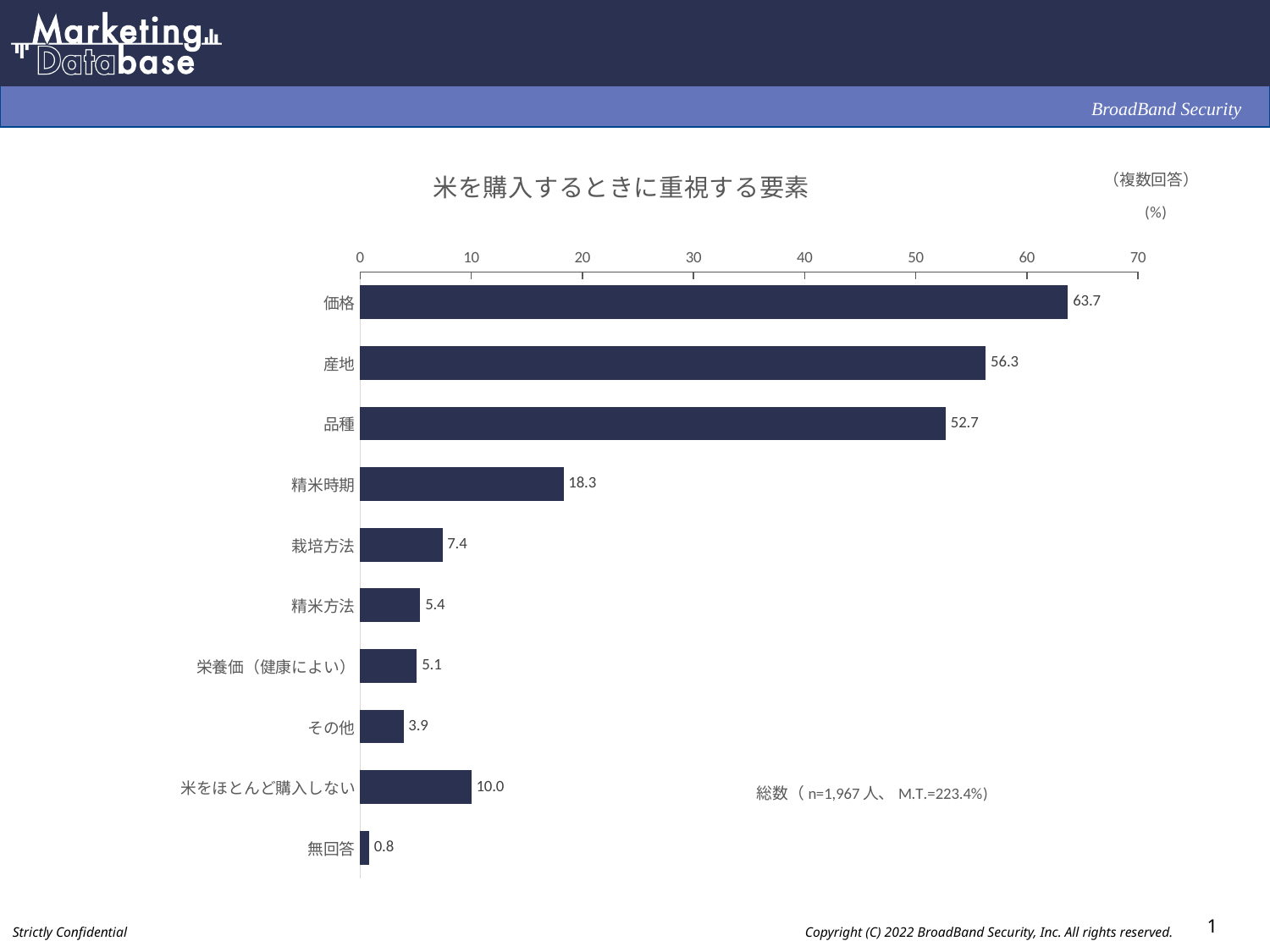
What is the value for 精米時期? 18.3 What kind of chart is shown on the slide? bar chart Which category has the highest value? 価格 Which is larger, the value for 栽培方法 or the value for 精米方法? 栽培方法 Is the value for 品種 greater or less than 50? greater What is the title of the chart? 米を購入するときに重視する要素 What is the value for 米をほとんど購入しない? 10.0 How many categories are shown in the chart? 10 What is the difference between the values for 産地 and 品種? 3.6 What is the value for 価格? 63.7 What is the sample size (n) shown on the slide? 1,967 Which category has the lowest value? 無回答